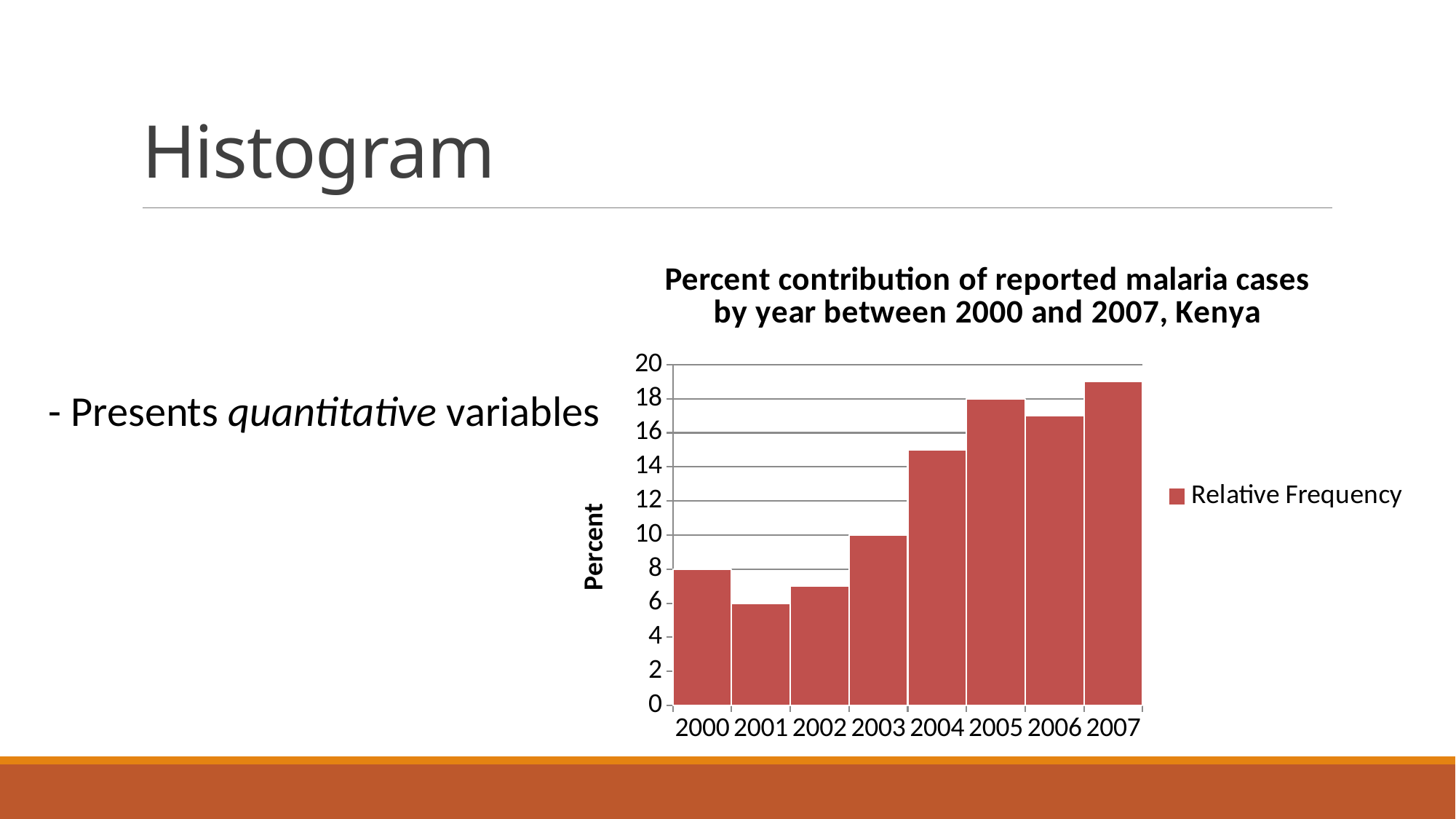
Is the value for 2007 greater or less than 18? greater How many years are shown on the x axis? 8 Which year has the highest value? 2007 What is the value for 2001? 6 Which year has the lowest value? 2001 Is the value for 2006 greater or less than 18? less What is the label on the y axis of the chart? Percent What is the difference between the values for 2005 and 2000? 10 Which is larger, the value for 2004 or the value for 2003? 2004 What is the value for 2005? 18 What is the value for 2000? 8 What kind of chart is shown on the slide? bar chart